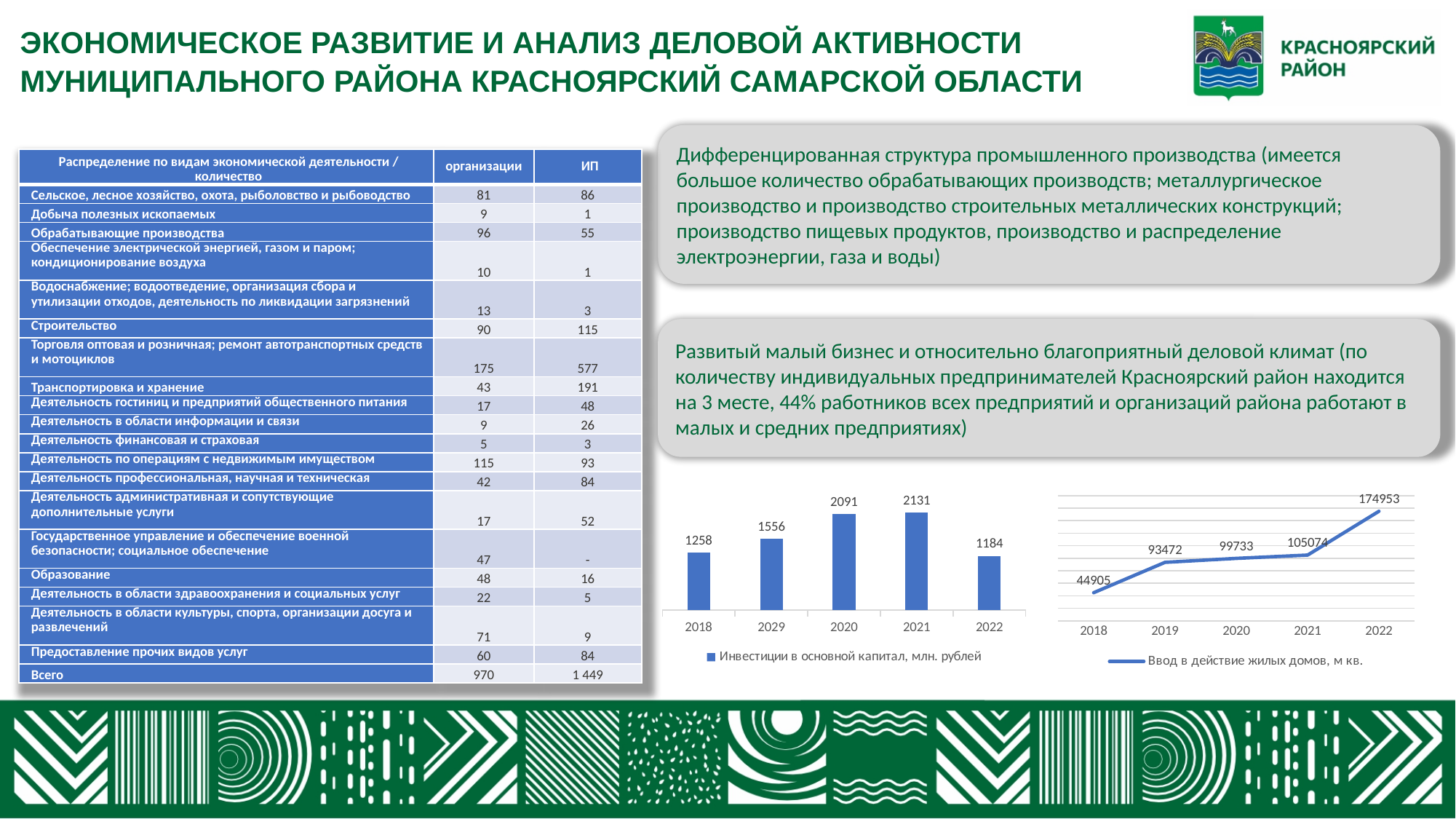
In the bar chart on the left (Инвестиции в основной капитал, млн. рублей), which year has the lowest value? 2022 In the bar chart on the left (Инвестиции в основной капитал, млн. рублей), what is the difference between the values for 2021 and 2018? 873 In the bar chart on the left (Инвестиции в основной капитал, млн. рублей), how many bars are plotted? 5 What type of chart is the left chart showing Инвестиции в основной капитал? bar chart In the line chart on the right (Ввод в действие жилых домов, м кв.), what is the value for 2019? 93472 In the bar chart on the left (Инвестиции в основной капитал, млн. рублей), what is the value for 2020? 2091 In the line chart on the right (Ввод в действие жилых домов, м кв.), do the values rise or fall from 2018 to 2022? rise In the bar chart on the left (Инвестиции в основной капитал, млн. рублей), what is the value for 2022? 1184 In the line chart on the right (Ввод в действие жилых домов, м кв.), what is the difference between the values for 2022 and 2021? 69879 In the line chart on the right (Ввод в действие жилых домов, м кв.), what is the value for 2022? 174953 In the line chart on the right (Ввод в действие жилых домов, м кв.), which is larger: the value for 2020 or the value for 2019? 2020 In the bar chart on the left (Инвестиции в основной капитал, млн. рублей), which year has the highest value? 2021